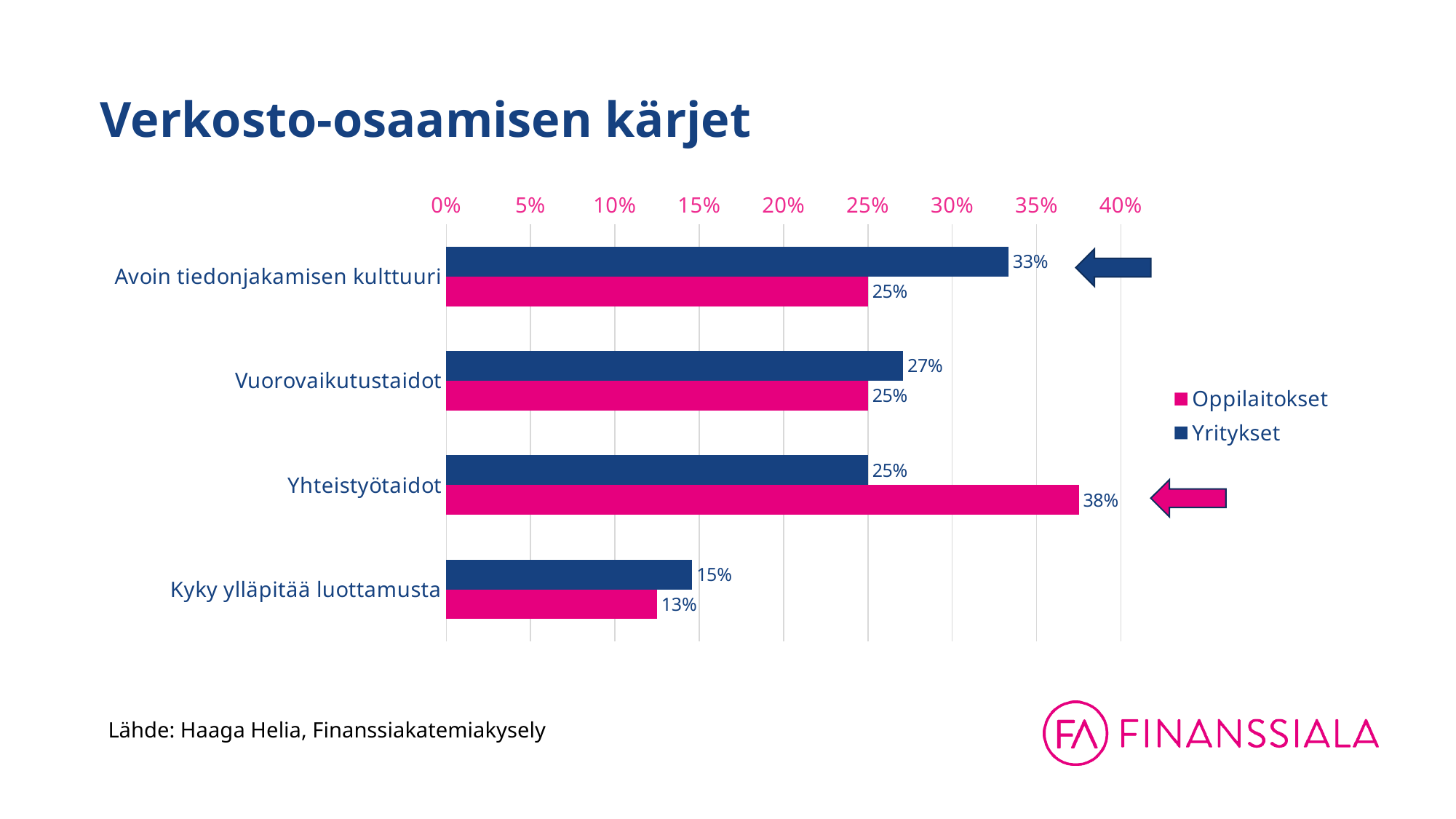
Which category has the lowest Oppilaitokset value? Kyky ylläpitää luottamusta How many categories are shown on the chart? 4 What kind of chart is shown on the slide? Bar chart For Avoin tiedonjakamisen kulttuuri, which series has the larger value, Oppilaitokset or Yritykset? Yritykset What is the Oppilaitokset value for Yhteistyötaidot? 38% What is the Yritykset value for Vuorovaikutustaidot? 27% How many series does the legend list? 2 What is the Oppilaitokset value for Kyky ylläpitää luottamusta? 13% What is the Yritykset value for Avoin tiedonjakamisen kulttuuri? 33% What is the title of the chart on the slide? Verkosto-osaamisen kärjet Which category has the highest Yritykset value? Avoin tiedonjakamisen kulttuuri What is the difference between the Oppilaitokset and Yritykset values for Yhteistyötaidot? 13%